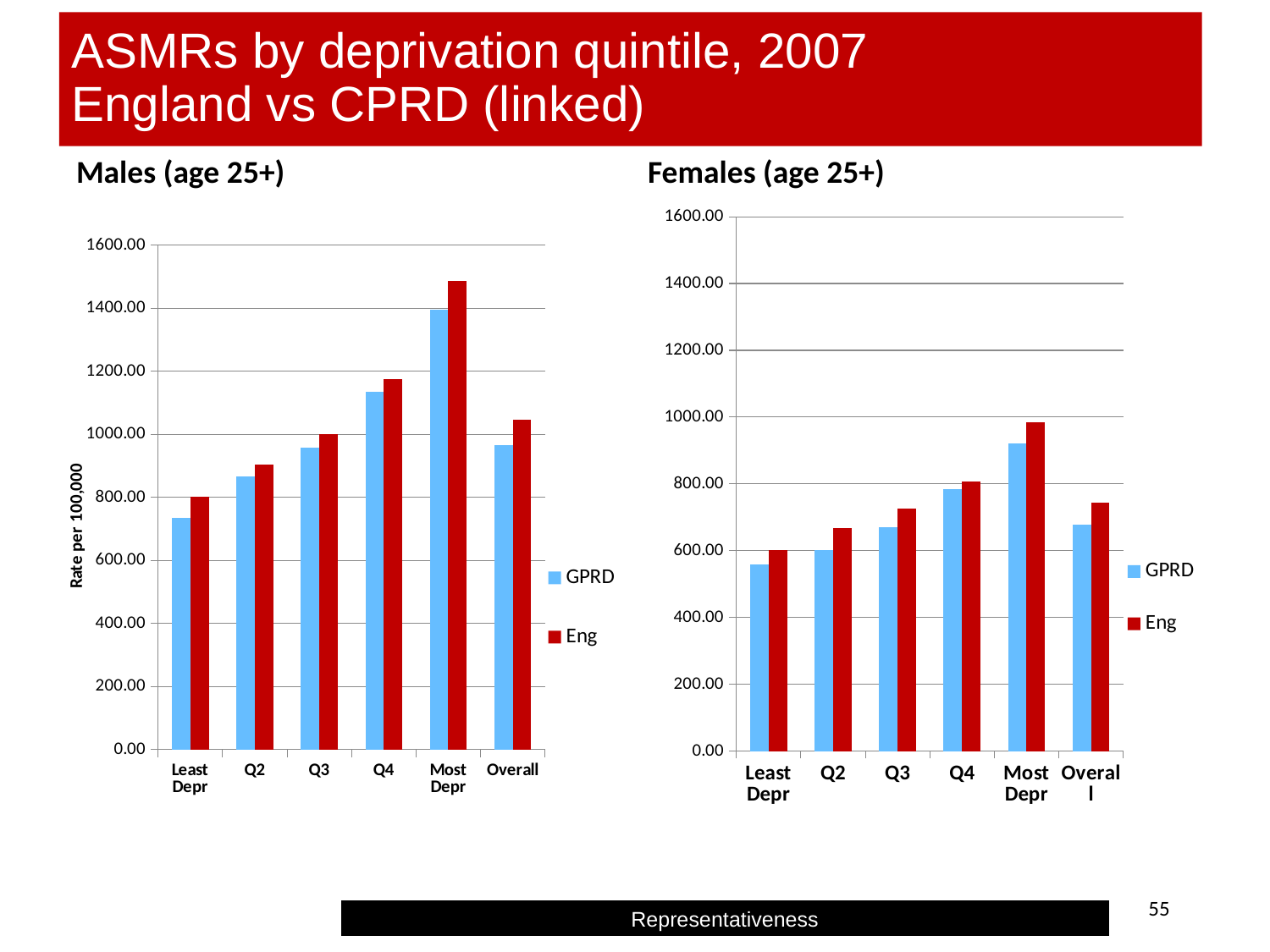
In the Males (age 25+) chart, do the GPRD values rise or fall from Least Depr to Most Depr? rise What is the y-axis title of the Males (age 25+) chart? Rate per 100,000 How many series does the legend of the Females (age 25+) chart list? 2 What kind of chart is the Males (age 25+) chart? bar chart In the Males (age 25+) chart, is the GPRD value for Most Depr greater or less than 1200? greater How many categories are shown on the x axis of the Males (age 25+) chart? 6 In the Males (age 25+) chart, which category has the highest Eng value? Most Depr In the Females (age 25+) chart, is the GPRD value for Least Depr greater or less than 600? less In the Males (age 25+) chart, which is larger for Q4: the GPRD value or the Eng value? Eng In the Females (age 25+) chart, which category has the lowest GPRD value? Least Depr In the Females (age 25+) chart, which is larger: the Eng value for Q2 or the Eng value for Q3? Q3